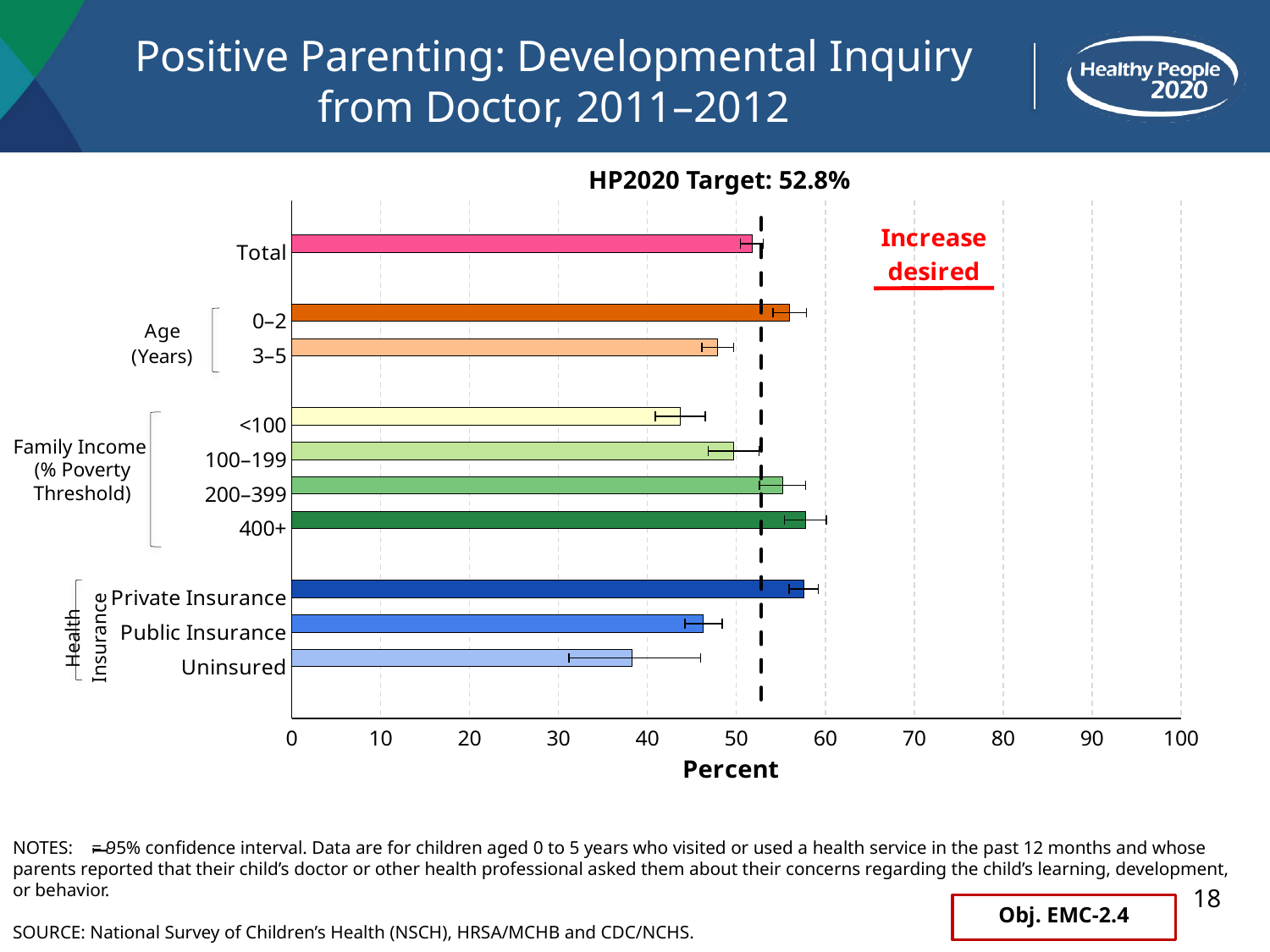
Which is larger, the value for Private Insurance or the value for Uninsured? Private Insurance Is the value for Private Insurance greater or less than 50? greater What is the label of the horizontal axis? Percent Is the value for 0–2 years greater or less than 50? greater Is the value for Uninsured greater or less than 50? less Which is larger, the value for <100 or the value for 400+ (Family Income)? 400+ How many bars (categories) are plotted in the chart? 10 What is the HP2020 Target value shown above the chart? 52.8% Which is larger, the value for 0–2 years or the value for 3–5 years? 0–2 Which category has the lowest value in the chart? Uninsured What kind of chart is shown on the slide? bar chart